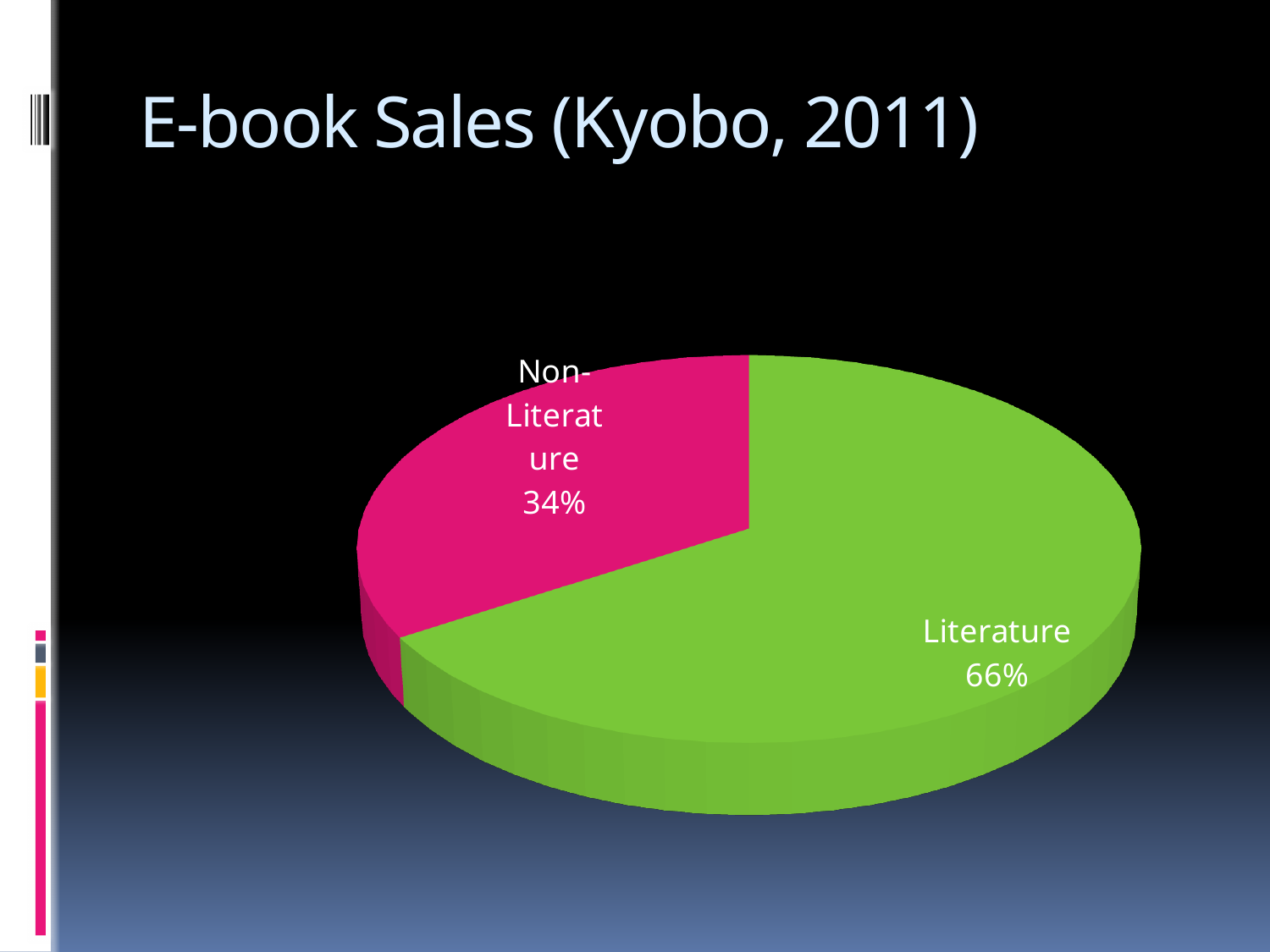
Is the share for Non-Literature greater or less than 50%? less What kind of chart is shown on the slide? pie chart What colour is the Literature slice? green Which category has the largest share of the pie? Literature Which category has the smallest share of the pie? Non-Literature What is the title of the slide containing the chart? E-book Sales (Kyobo, 2011) Which is larger, the Literature slice or the Non-Literature slice? Literature What is the difference in percentage points between Literature and Non-Literature? 32 What share of e-book sales is Non-Literature? 34% What share of e-book sales is Literature? 66% How many slices does the pie chart have? 2